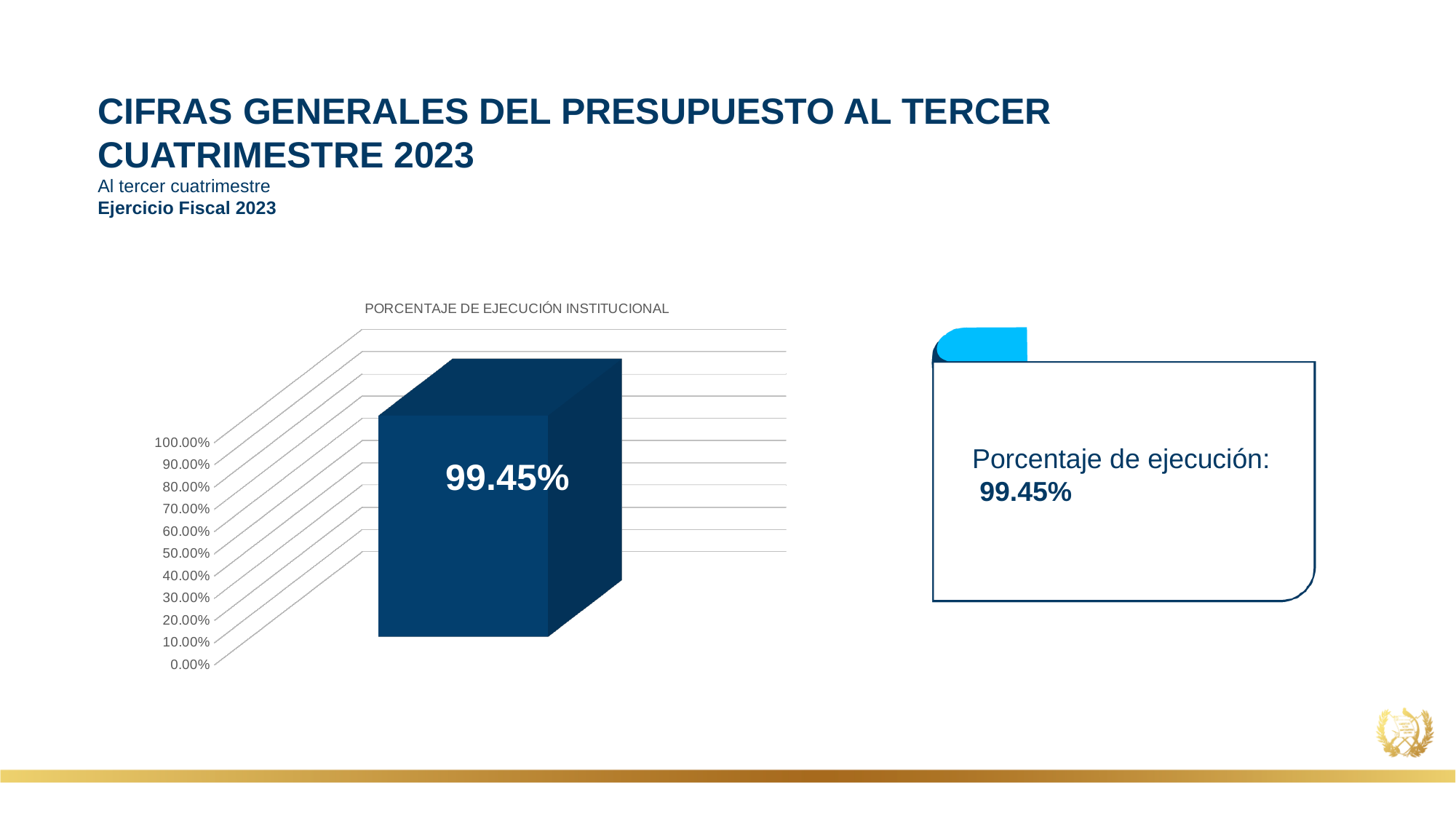
What value is printed on the bar in the chart? 99.45% How many bars are plotted in the chart? 1 Is the value of the bar greater or less than 90.00%? greater Is the value of the bar greater or less than 100.00%? less What is the highest tick label shown on the vertical axis of the chart? 100.00% What is the title of the chart? PORCENTAJE DE EJECUCIÓN INSTITUCIONAL What kind of chart is shown on the slide? bar chart What is the lowest tick label shown on the vertical axis of the chart? 0.00%